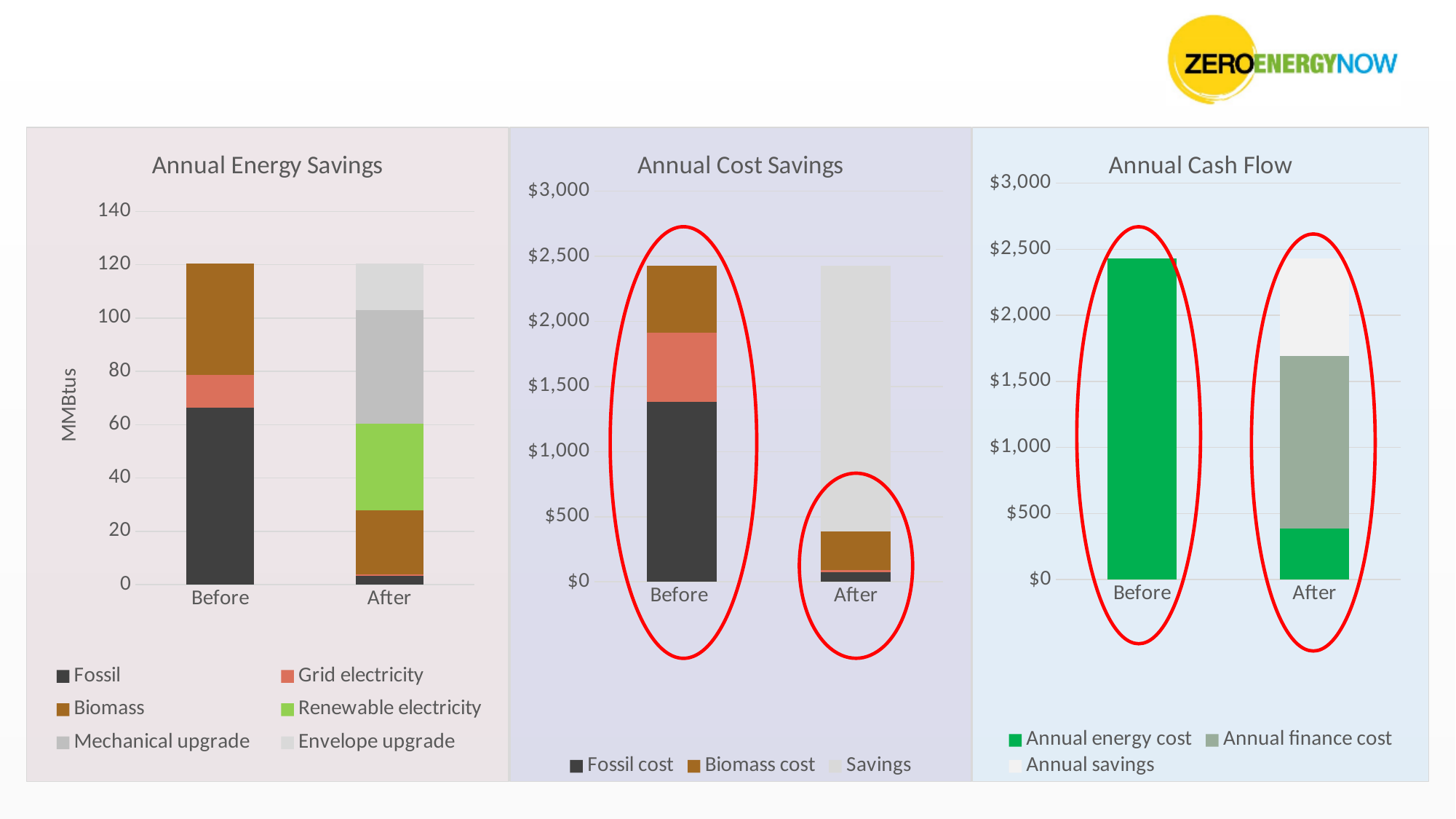
How many series does the legend of the Annual Cash Flow chart list? 3 In the Annual Energy Savings chart, is the Fossil value for Before greater or less than 40? greater In the Annual Cost Savings chart, which category has the larger Savings value, Before or After? After How many series does the legend of the Annual Energy Savings chart list? 6 How many series does the legend of the Annual Cost Savings chart list? 3 What unit is shown on the y axis of the Annual Energy Savings chart? MMBtus How many categories are shown on the x axis of the Annual Energy Savings chart? 2 In the Annual Cash Flow chart, which category has the larger Annual energy cost, Before or After? Before In the Annual Energy Savings chart, which category has the larger Fossil value, Before or After? Before What kind of chart is the Annual Energy Savings chart? bar chart In the Annual Cost Savings chart, is the Fossil cost for Before greater or less than $1,000? greater In the Annual Cash Flow chart, is the Annual energy cost for After greater or less than $500? less